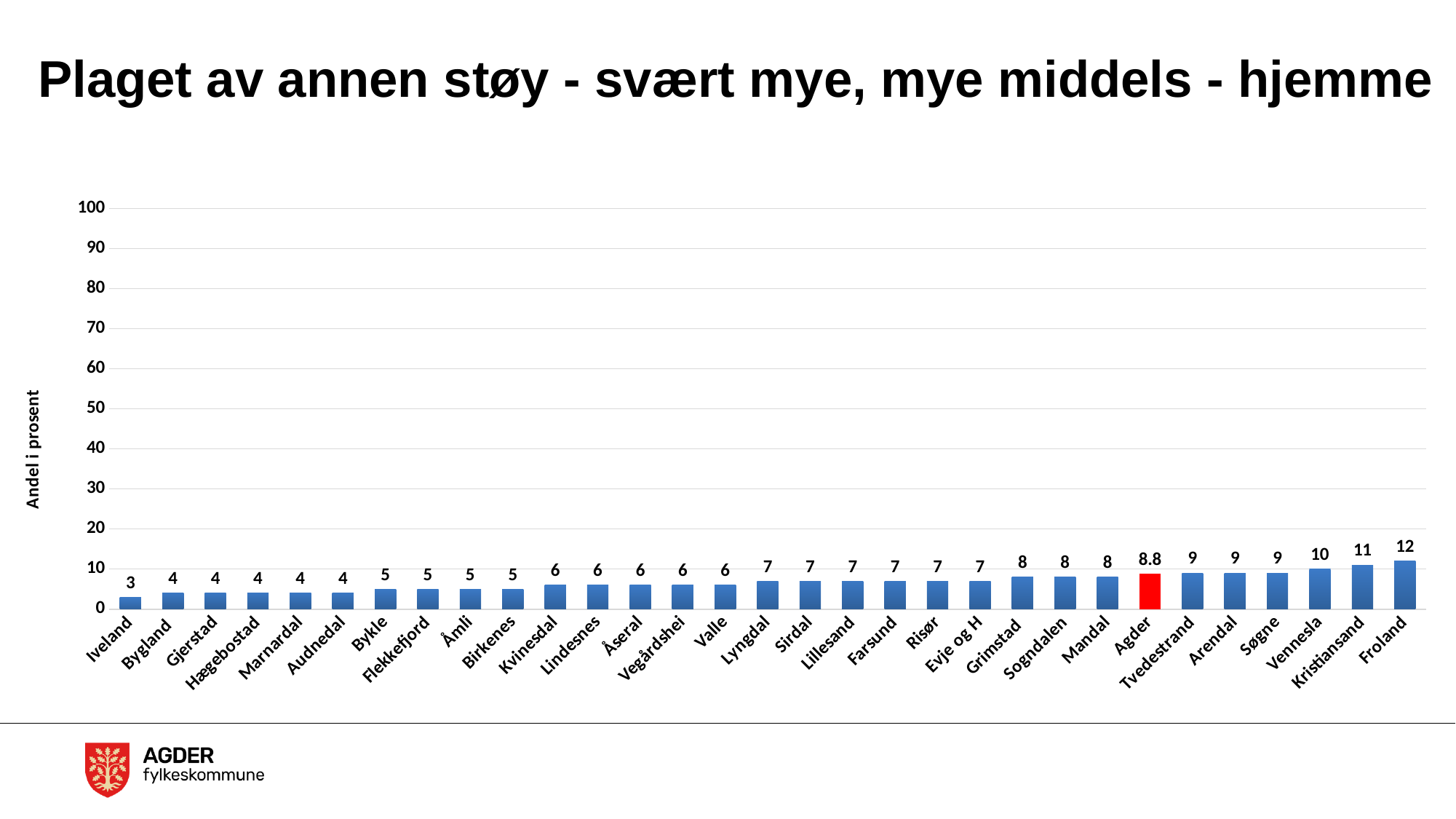
What is the difference between the values for Froland and Iveland? 9 What is the value for Iveland? 3 Which category has the lowest value? Iveland Which bar is coloured red instead of blue? Agder What is the value for Froland? 12 What is the value for Agder? 8.8 Is the value for Kristiansand greater or less than 20? less Which category has the highest value? Froland What kind of chart is shown on the slide? bar chart What is the value for Kristiansand? 11 Which is larger, the value for Vennesla or the value for Bykle? Vennesla How many categories are shown on the x axis? 31